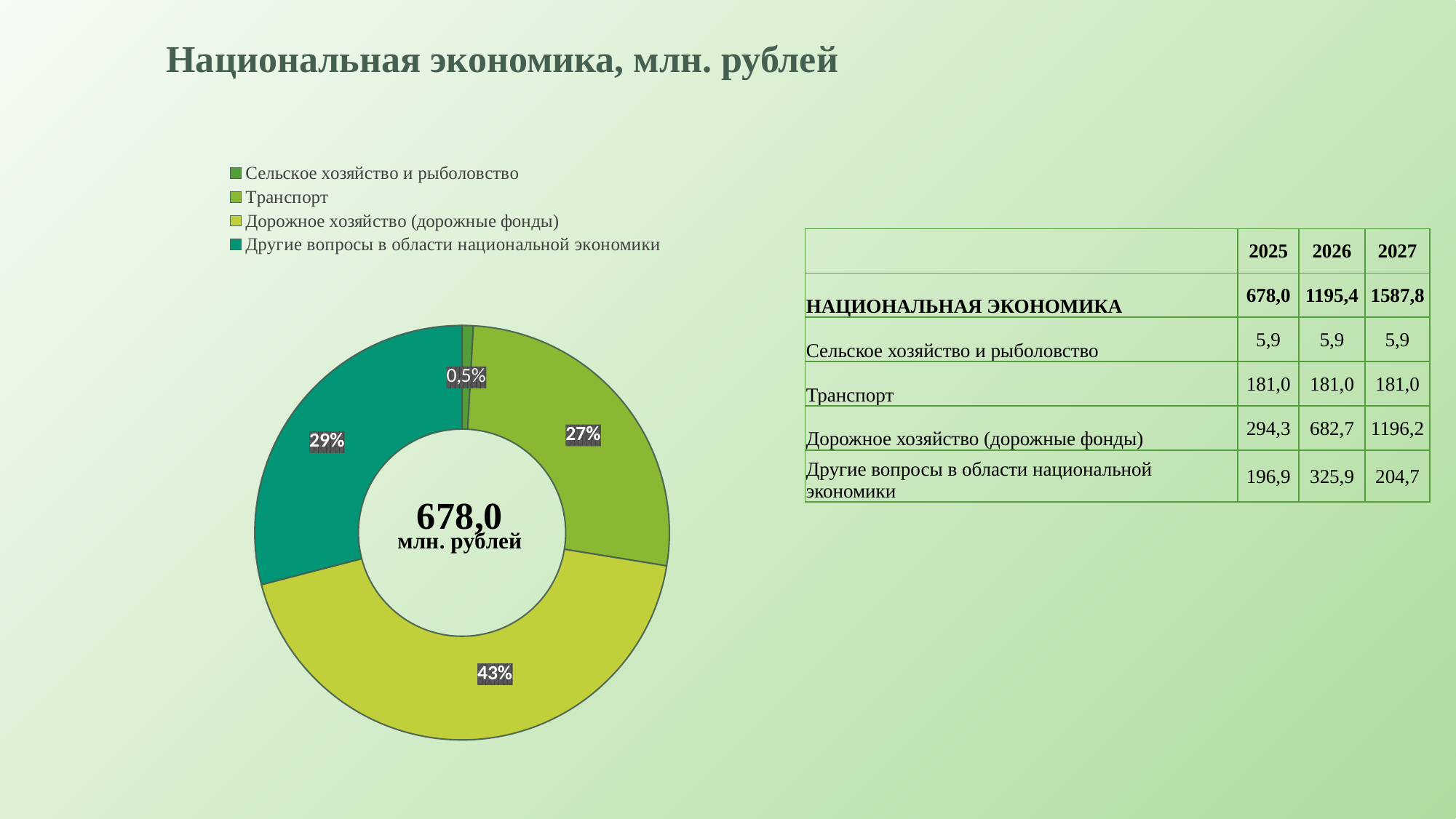
How many categories does the doughnut chart show? 4 What is the difference in percentage points between the Дорожное хозяйство (дорожные фонды) slice and the Транспорт slice? 16 percentage points Which slice is larger in the doughnut chart: Транспорт or Другие вопросы в области национальной экономики? Другие вопросы в области национальной экономики Which category has the smallest slice in the doughnut chart? Сельское хозяйство и рыболовство What is the title of the slide containing the doughnut chart? Национальная экономика, млн. рублей What share of the doughnut chart does Транспорт take? 27% What share of the doughnut chart does Сельское хозяйство и рыболовство take? 0,5% What share of the doughnut chart does Другие вопросы в области национальной экономики take? 29% Which category has the largest slice in the doughnut chart? Дорожное хозяйство (дорожные фонды) What total value is printed in the centre of the doughnut chart? 678,0 млн. рублей What kind of chart is shown on the slide? Doughnut (pie) chart